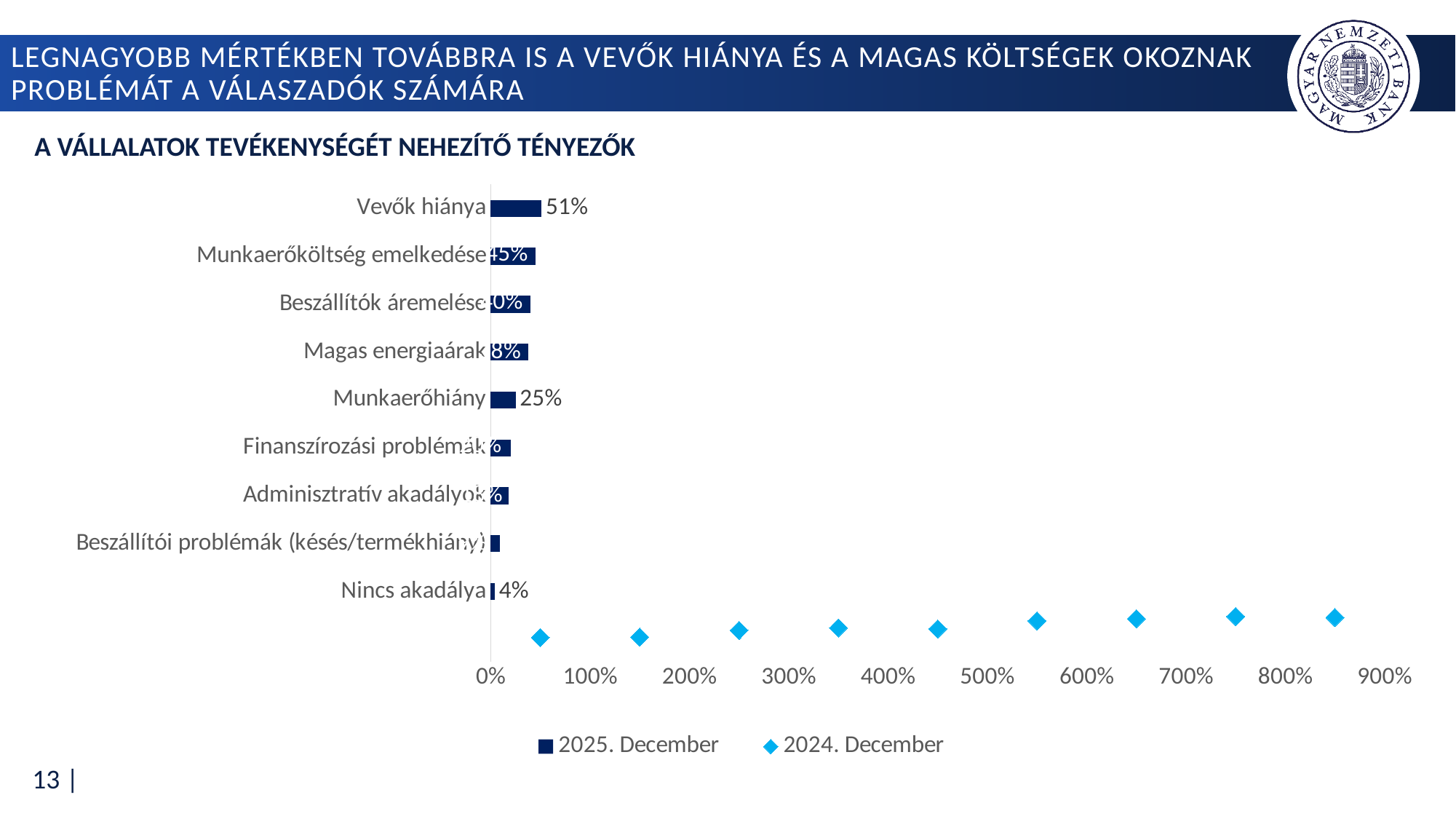
What is the value for Vevők hiánya in the 2025. December series? 51% What is the difference between the 2025. December values for Vevők hiánya and Munkaerőhiány? 26% What is the value for Nincs akadálya in the 2025. December series? 4% Which category has the highest 2025. December value? Vevők hiánya How many categories are shown on the chart? 9 Is the 2025. December value for Magas energiaárak greater or less than 100%? less Which has a larger 2025. December value, Vevők hiánya or Munkaerőhiány? Vevők hiánya What is the title of the chart? A vállalatok tevékenységét nehezítő tényezők Which category has the lowest 2025. December value? Nincs akadálya What kind of chart is shown on the slide? bar chart How many series does the legend list? 2 What is the value for Munkaerőhiány in the 2025. December series? 25%